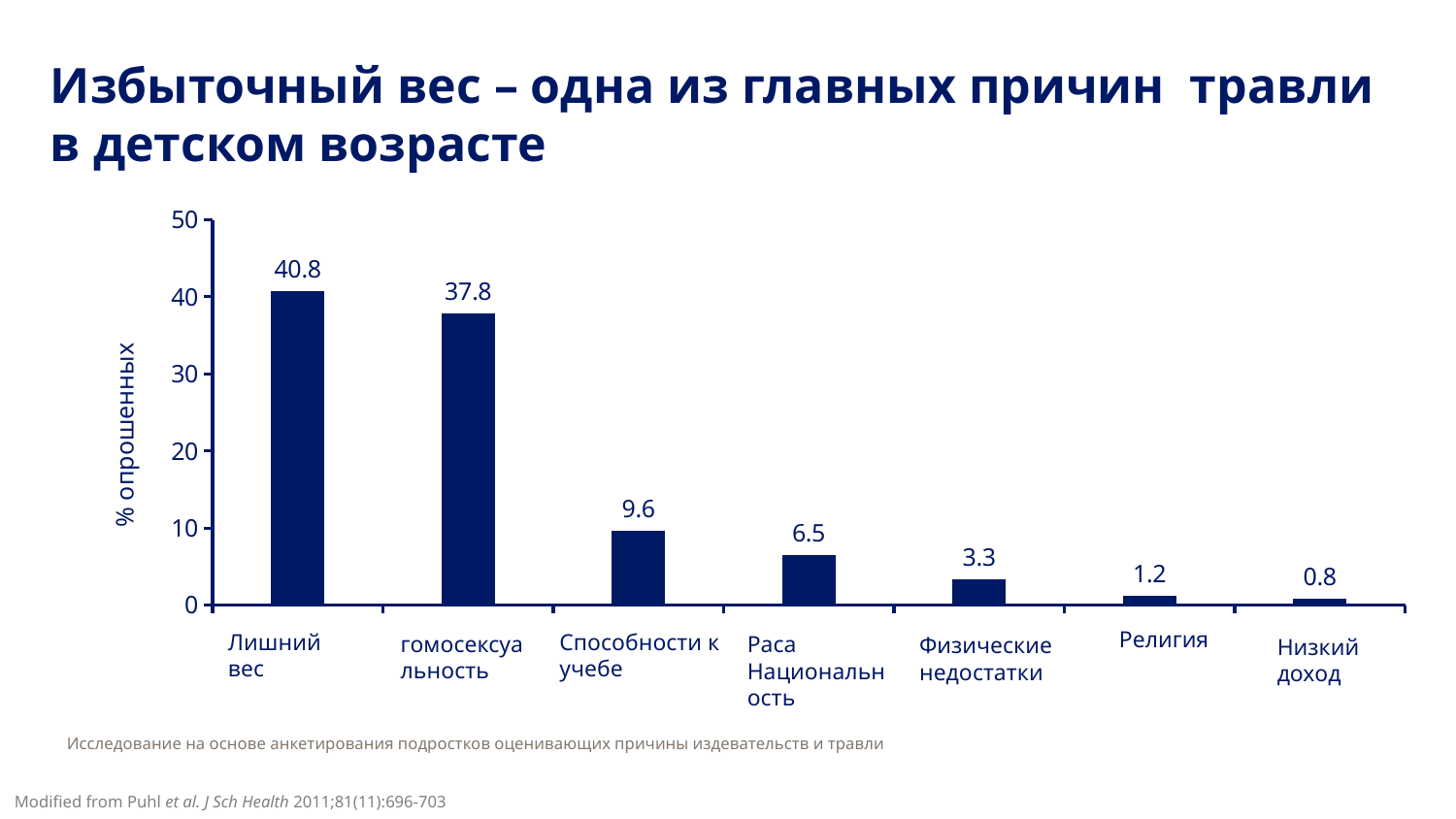
Which category has the lowest value? Низкий доход Which is larger, the value for Физические недостатки or the value for Религия? Физические недостатки What is the label of the vertical axis? % опрошенных Which category has the highest value? Лишний вес How many categories are shown on the chart? 7 What is the difference between the values for Способности к учебе and Раса Национальность? 3.1 Is the value for гомосексуальность greater or less than 30? greater What is the value for Способности к учебе? 9.6 What is the value for Лишний вес? 40.8 What is the difference between the values for Лишний вес and гомосексуальность? 3.0 What is the value for Религия? 1.2 What kind of chart is shown on the slide? bar chart